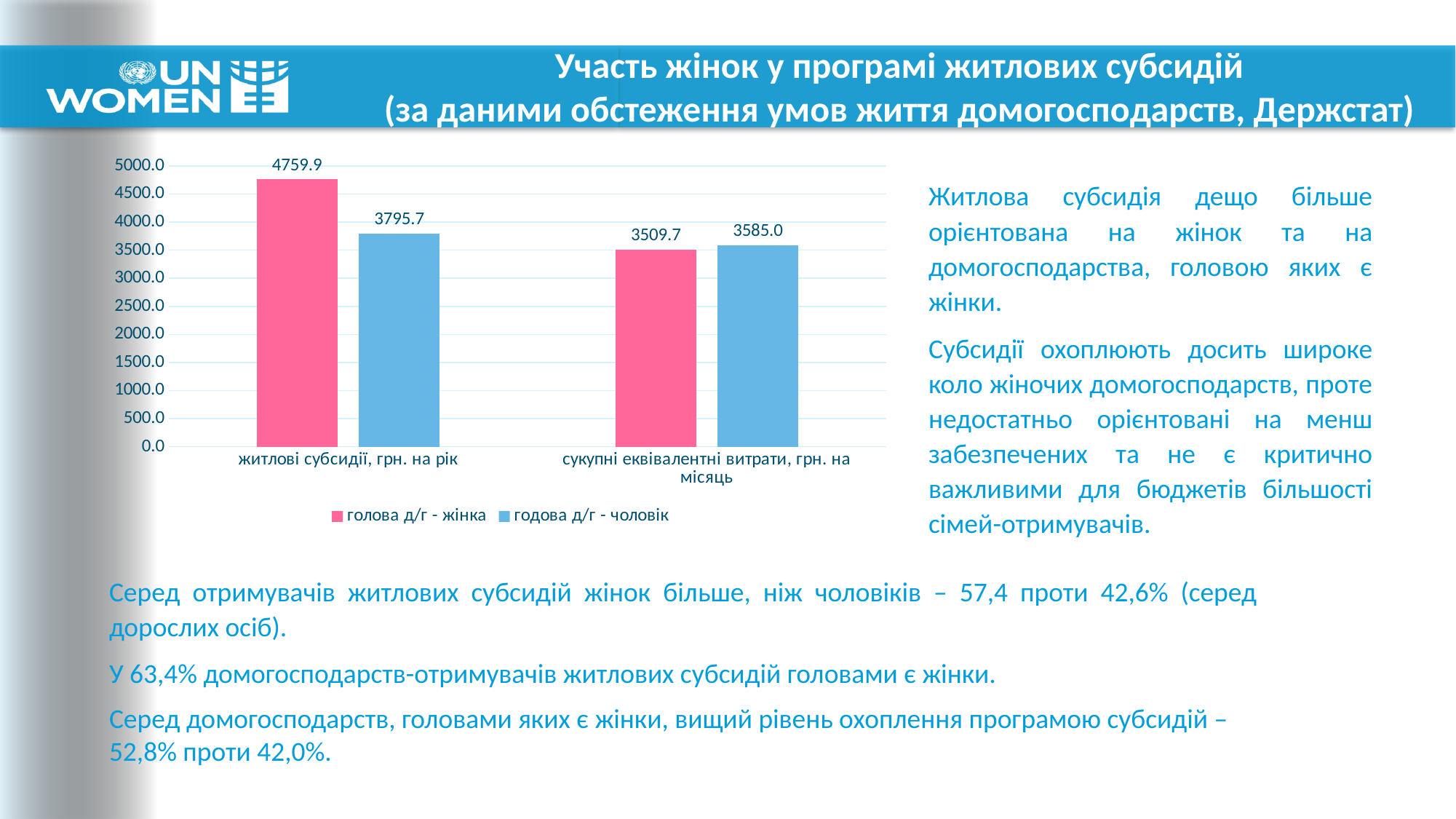
Which bar has the lowest value in the chart? голова д/г - жінка, сукупні еквівалентні витрати, грн. на місяць What is the difference between the 'голова д/г - жінка' and 'годова д/г - чоловік' values for 'житлові субсидії, грн. на рік'? 964.2 How many series does the chart legend list? 2 What colour are the bars for the series 'голова д/г - жінка'? pink Which bar has the highest value in the chart? голова д/г - жінка, житлові субсидії, грн. на рік What is the value for 'годова д/г - чоловік' in the category 'житлові субсидії, грн. на рік'? 3795.7 How many categories are shown on the x axis of the chart? 2 What type of chart is shown on the slide? bar chart What is the value for 'голова д/г - жінка' in the category 'житлові субсидії, грн. на рік'? 4759.9 In the category 'сукупні еквівалентні витрати, грн. на місяць', which series has the larger value: 'голова д/г - жінка' or 'годова д/г - чоловік'? годова д/г - чоловік What is the value for 'годова д/г - чоловік' in the category 'сукупні еквівалентні витрати, грн. на місяць'? 3585.0 What is the value for 'голова д/г - жінка' in the category 'сукупні еквівалентні витрати, грн. на місяць'? 3509.7